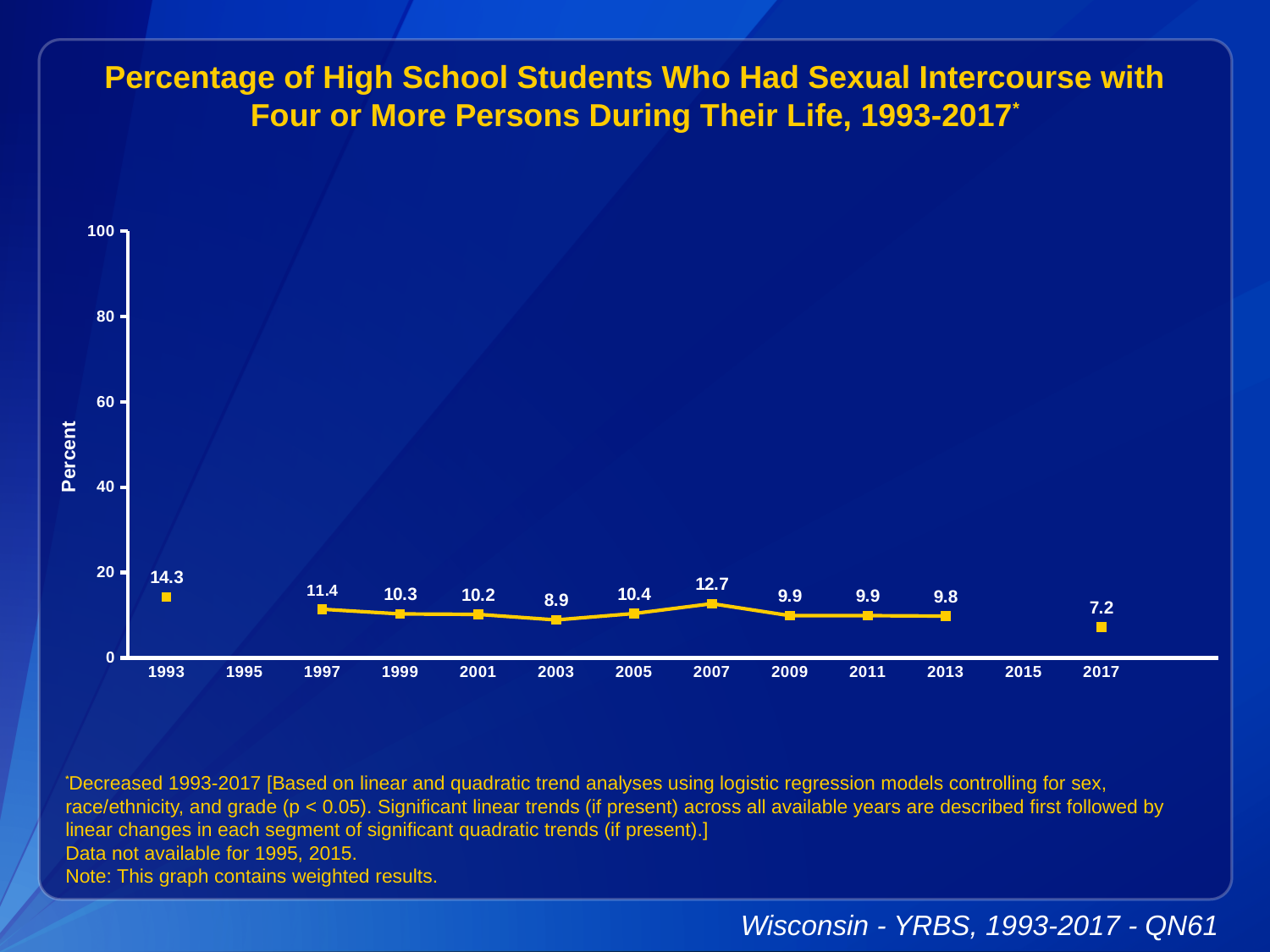
What is the value for 2017? 7.2 What is the value for 1993? 14.3 Which year has the highest value? 1993 What kind of chart is shown on the slide? line chart How many years have data points plotted on the chart? 11 Which is larger, the value for 2003 or the value for 2007? 2007 What is the label on the y axis? Percent Which year has the lowest value? 2017 Is the value for 1993 greater or less than 20? less What is the value for 2007? 12.7 What is the difference between the values for 1993 and 2017? 7.1 Do the values generally rise or fall from 1993 to 2017? fall